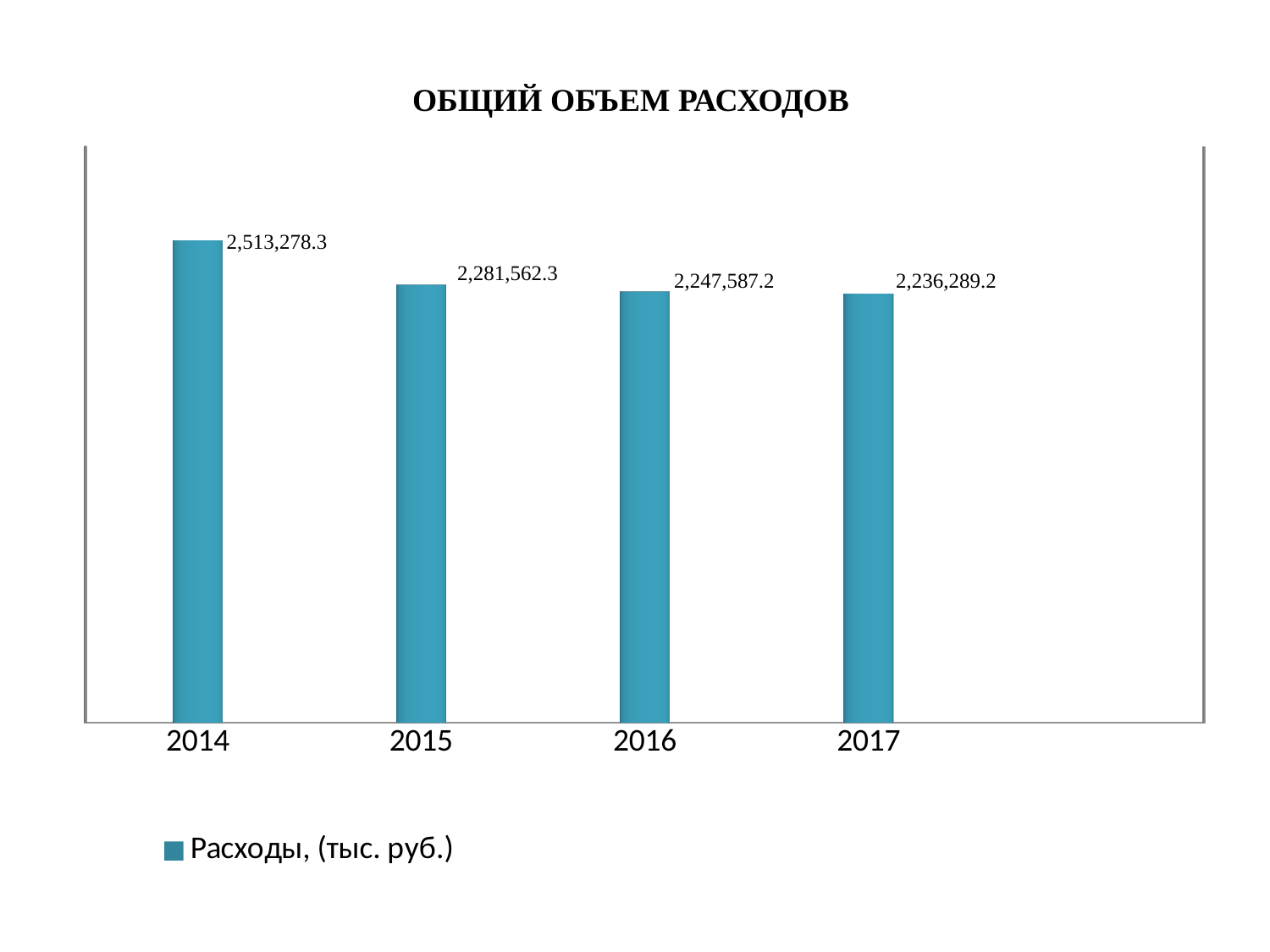
How many years are shown on the x axis? 4 What is the value for 2015? 2,281,562.3 What is the value for 2017? 2,236,289.2 What kind of chart is this? bar chart Which is larger, the value for 2014 or the value for 2015? 2014 What is the difference between the values for 2016 and 2017? 11,298.0 What is the value for 2016? 2,247,587.2 Which year has the lowest value? 2017 Which year has the highest value? 2014 What is the value for 2014? 2,513,278.3 What is the difference between the values for 2014 and 2015? 231,716.0 Do the values rise or fall from 2014 to 2017? fall